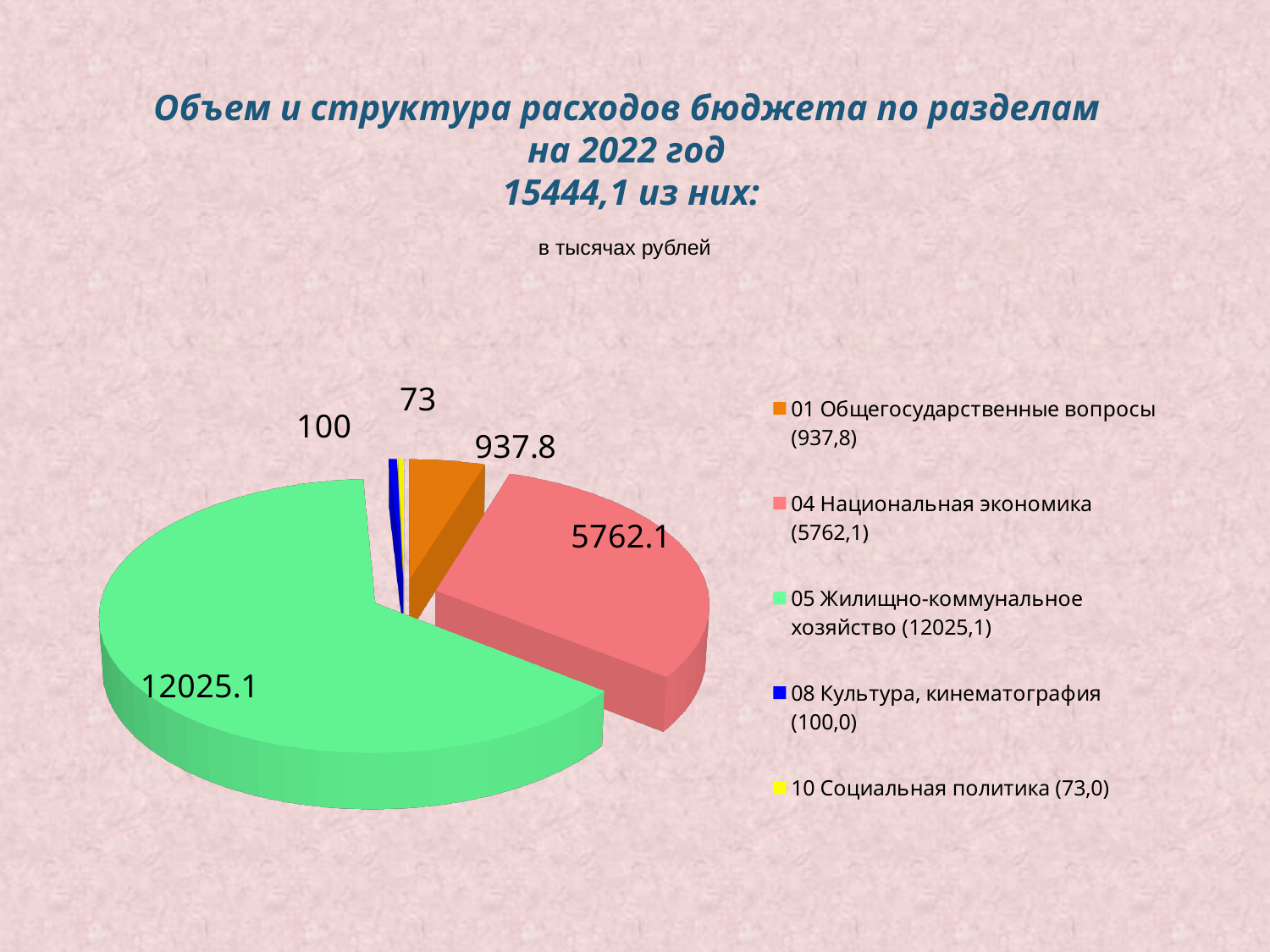
Which category has the smallest slice of the pie? 10 Социальная политика Which category has the largest slice of the pie? 05 Жилищно-коммунальное хозяйство How many slices does the pie chart have? 5 What is the value for 04 Национальная экономика? 5762.1 What is the difference between the values for 05 Жилищно-коммунальное хозяйство and 04 Национальная экономика? 6263 What is the value for 10 Социальная политика? 73 What is the value for 01 Общегосударственные вопросы? 937.8 What is the difference between the values for 08 Культура, кинематография and 10 Социальная политика? 27 What is the value for 05 Жилищно-коммунальное хозяйство? 12025.1 What type of chart is shown on the slide? pie chart Which is larger, the value for 01 Общегосударственные вопросы or the value for 08 Культура, кинематография? 01 Общегосударственные вопросы What unit is stated for the values on the slide? в тысячах рублей